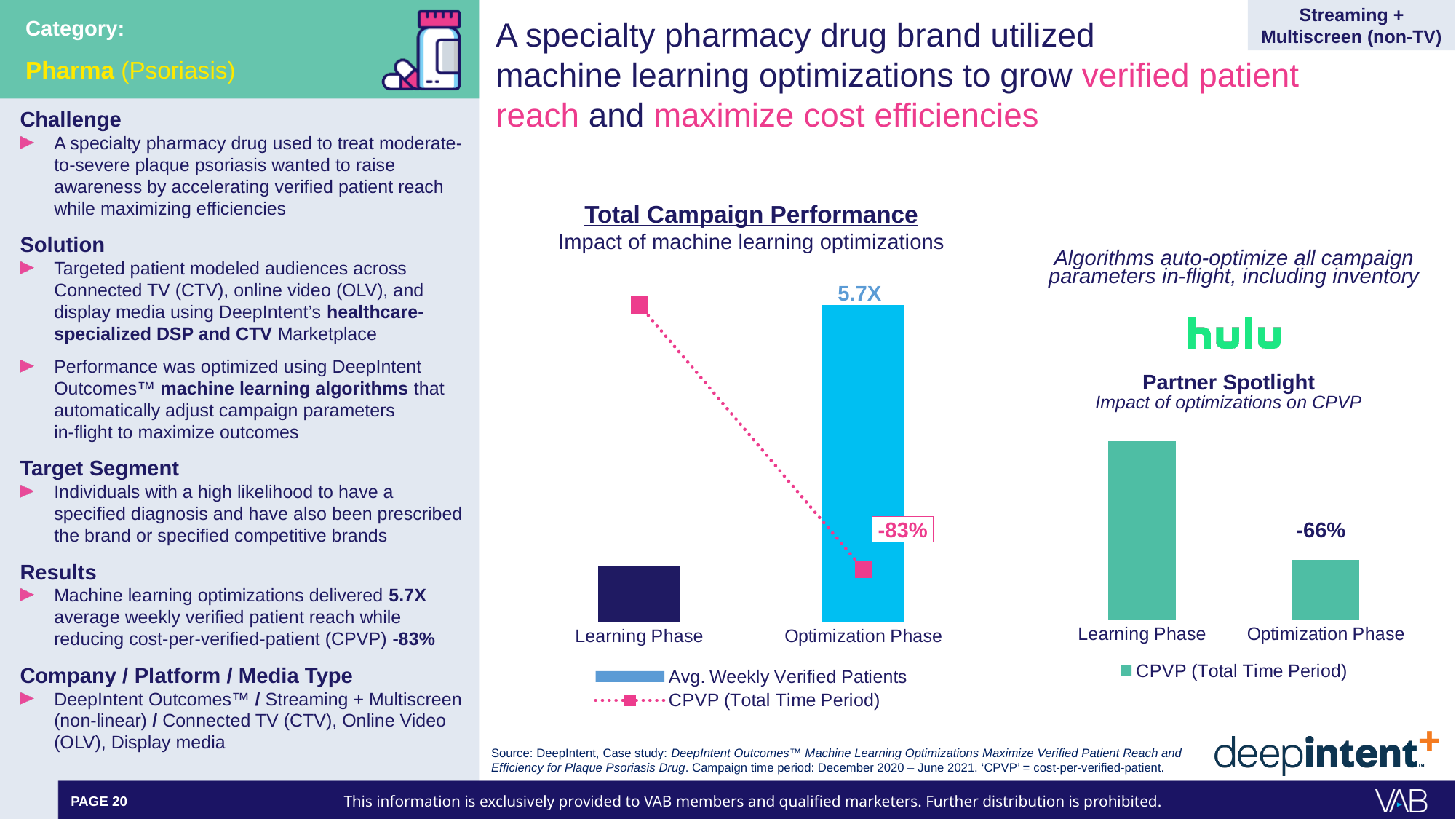
In the Total Campaign Performance chart, does the CPVP (Total Time Period) line rise or fall from the Learning Phase to the Optimization Phase? Fall In the Total Campaign Performance chart, what data label is shown for CPVP (Total Time Period) at the Optimization Phase? -83% In the Partner Spotlight chart, what data label is shown on the Optimization Phase bar? -66% In the Total Campaign Performance chart, is the CPVP value higher in the Learning Phase or the Optimization Phase? Learning Phase In the Partner Spotlight chart, is the CPVP bar for the Learning Phase taller or shorter than the Optimization Phase bar? Taller What is the subtitle of the Total Campaign Performance chart? Impact of machine learning optimizations What kind of chart is the Partner Spotlight chart? Bar chart How many series does the legend of the Total Campaign Performance chart list? 2 In the Partner Spotlight chart, which phase has the lower CPVP bar? Optimization Phase In the Total Campaign Performance chart, what data label is shown on the Optimization Phase bar for Avg. Weekly Verified Patients? 5.7X How many categories are shown on the x axis of the Partner Spotlight chart? 2 In the Total Campaign Performance chart, which phase has the taller Avg. Weekly Verified Patients bar? Optimization Phase